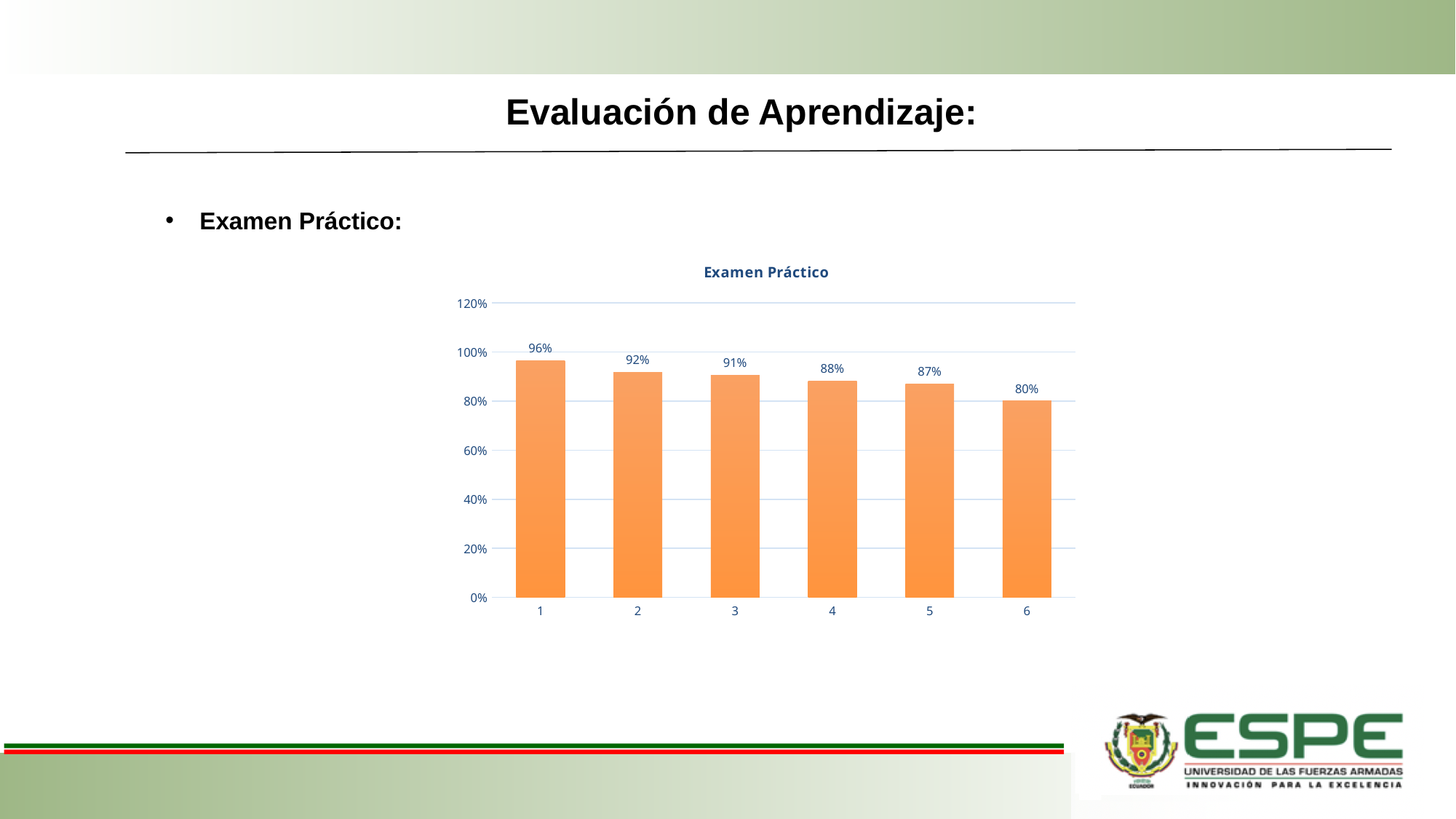
What is the value for category 4? 88% What is the difference between the values for category 2 and category 5? 5% Which category has the lowest value? 6 Do the values rise or fall from category 1 to category 6? fall What is the value for category 1? 96% How many categories are shown on the x axis? 6 What is the title of the chart? Examen Práctico Which category has the highest value? 1 What is the difference between the values for category 1 and category 6? 16% What is the value for category 6? 80% Which is larger, the value for category 3 or the value for category 5? 3 What kind of chart is shown? bar chart